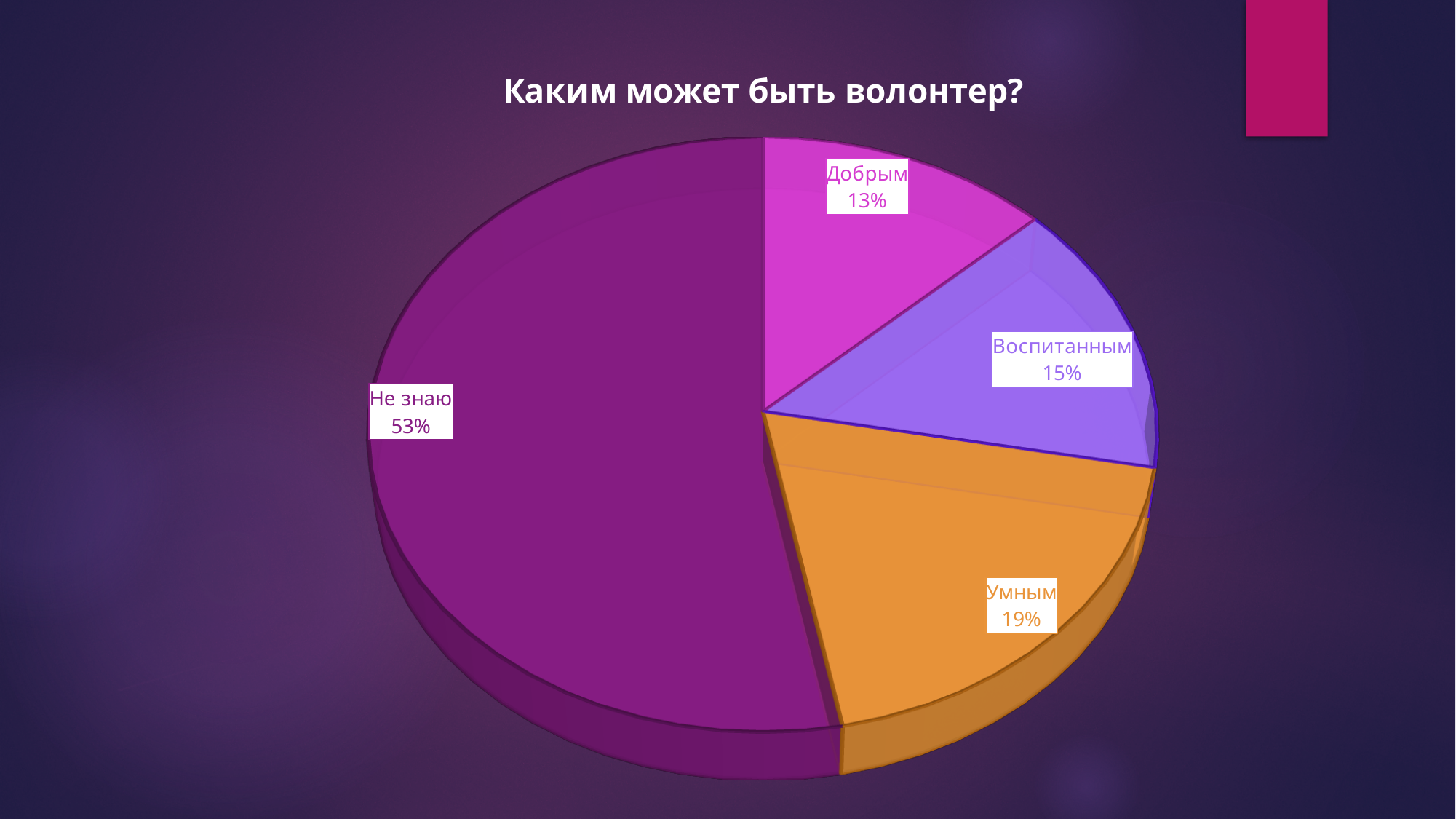
What is the value for "Воспитанным"? 15% What kind of chart is shown on the slide? pie chart What is the difference between the shares for "Не знаю" and "Умным"? 34% What is the title of the chart? Каким может быть волонтер? How many slices does the pie chart have? 4 Which category has the smallest share of the pie? Добрым Which is larger, the share for "Умным" or the share for "Воспитанным"? Умным What share of the pie is labelled "Не знаю"? 53% What is the value for "Умным"? 19% What is the value for "Добрым"? 13% Which category has the largest share of the pie? Не знаю What colour is the "Умным" slice? orange